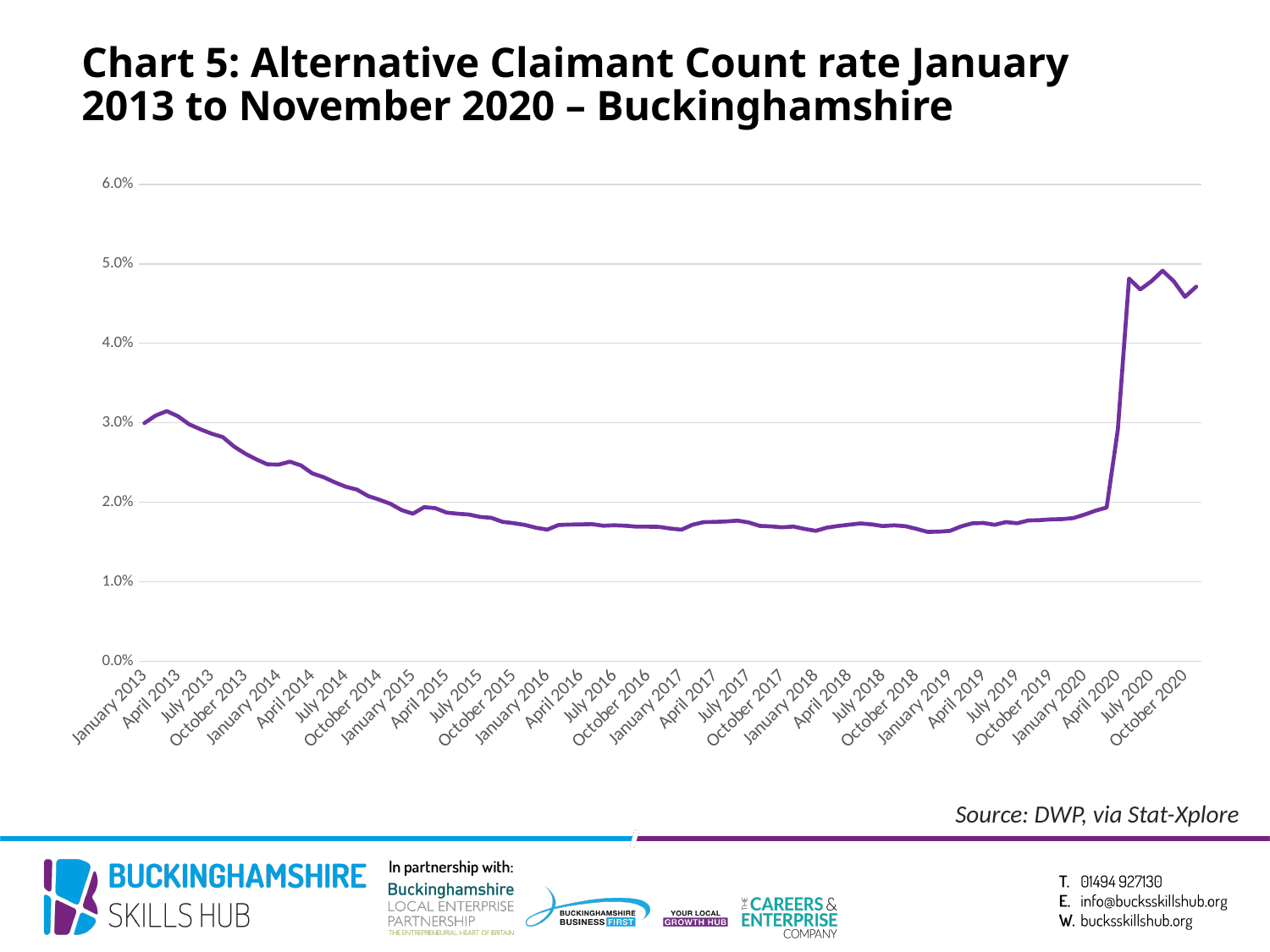
Is the value for January 2016 greater or less than 2.0%? less Is the value for July 2020 greater or less than 4.0%? greater Is the value for October 2013 greater or less than 3.0%? less What kind of chart is shown on the slide? line chart Does the claimant count rate rise or fall between January 2013 and January 2016? fall Which is larger, the value for January 2013 or the value for January 2016? January 2013 What is the title of the chart? Chart 5: Alternative Claimant Count rate January 2013 to November 2020 – Buckinghamshire What source is cited for the chart data? DWP, via Stat-Xplore Which is larger, the value for January 2020 or the value for October 2020? October 2020